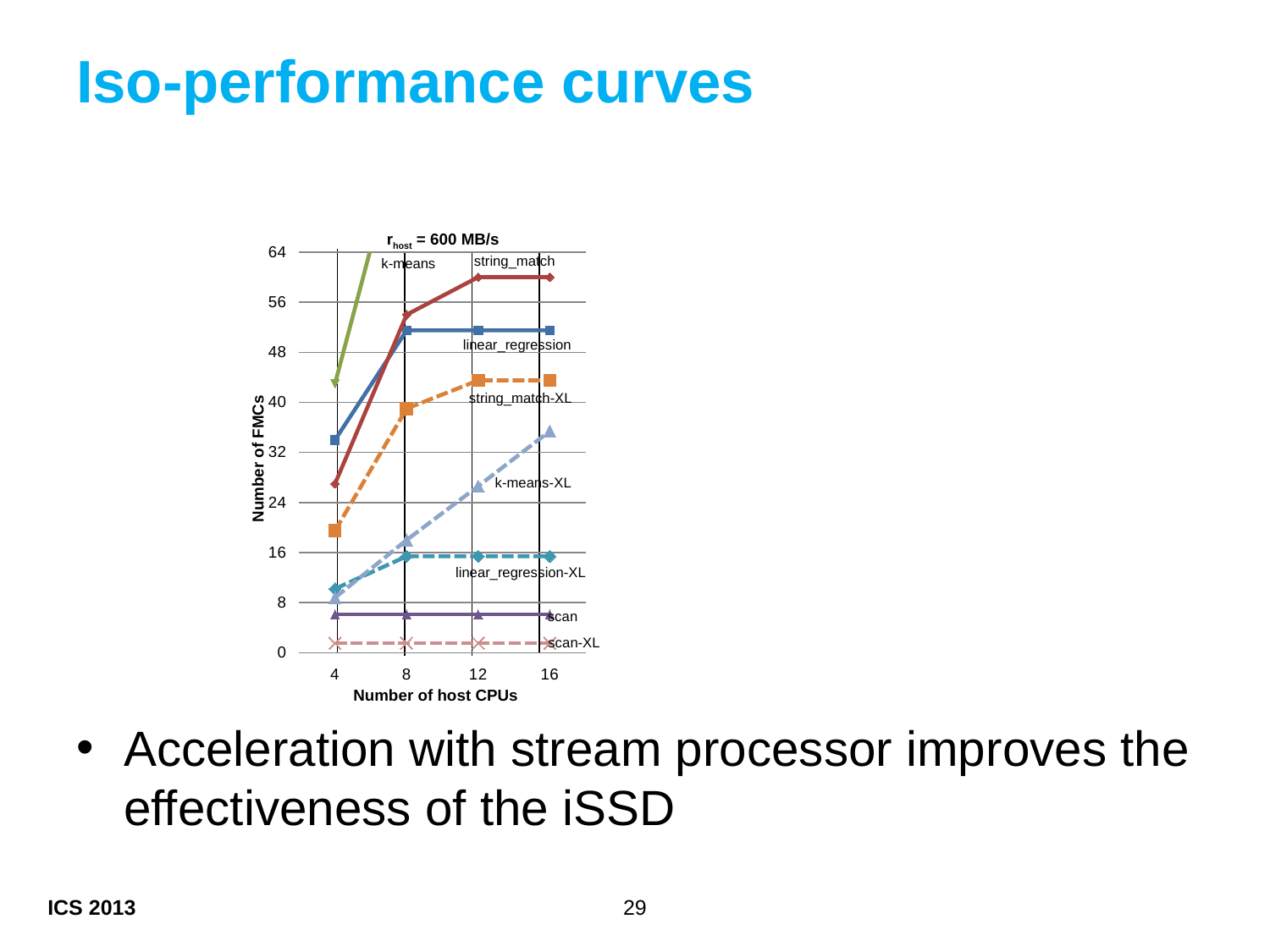
How many labelled series (curves) are plotted in the chart? 8 At 16 host CPUs, which is higher: string_match or linear_regression? string_match Is the value for linear_regression-XL at 16 host CPUs greater or less than 24? less Is the value for k-means-XL at 16 host CPUs greater or less than 32? greater How many values of Number of host CPUs are marked on the x axis? 4 Is the value for scan at 16 host CPUs greater or less than 8? less At 16 host CPUs, which is higher: scan or scan-XL? scan Does the k-means-XL curve rise or fall as the number of host CPUs increases from 4 to 16? rise What is the label of the y axis? Number of FMCs What kind of chart is shown on the slide? line chart What is the title of the chart? r_host = 600 MB/s